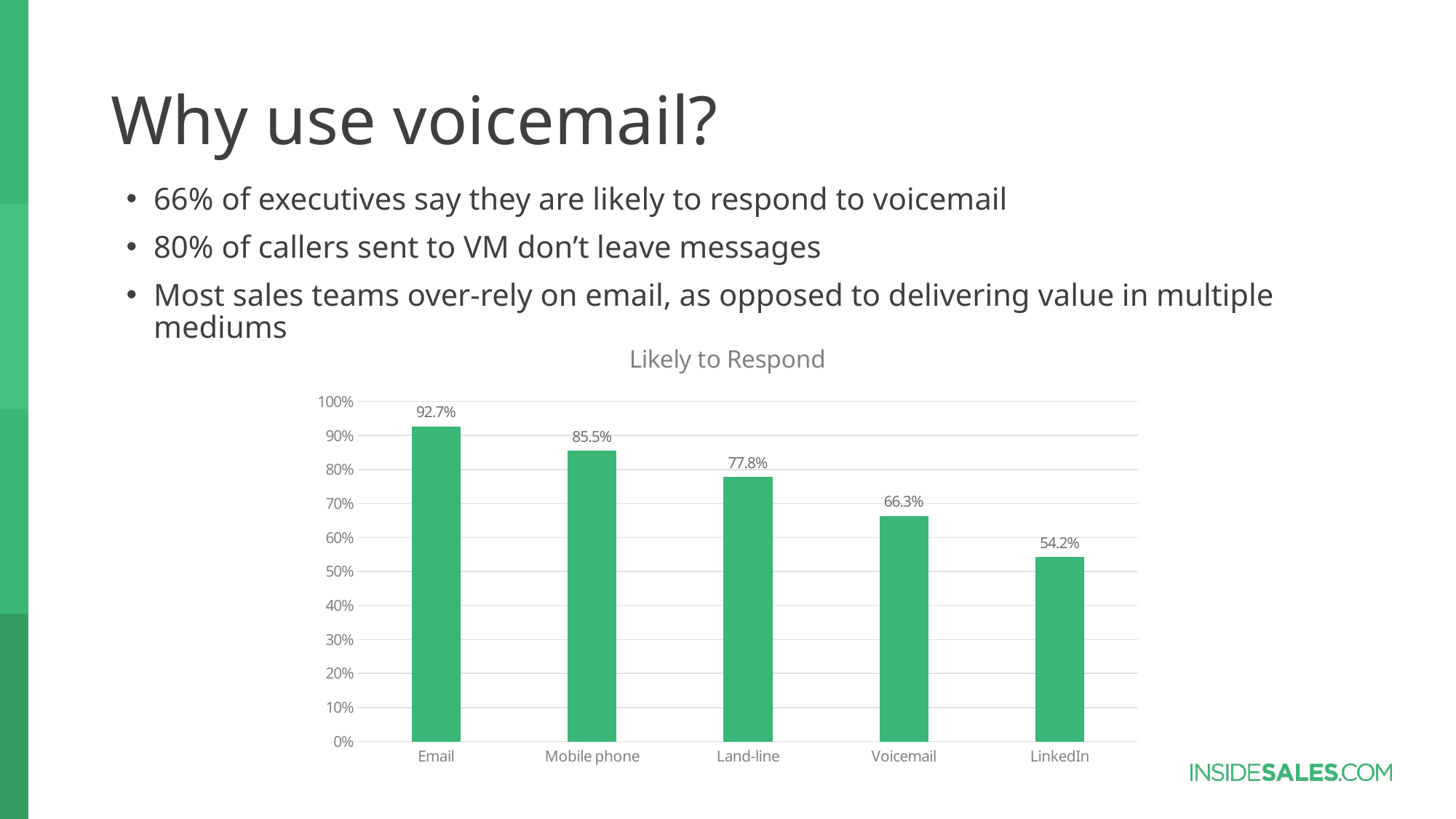
What is the value for LinkedIn? 54.2% Which category has the highest value? Email What is the value for Voicemail? 66.3% What is the title of the chart? Likely to Respond Is the value for Mobile phone greater or less than 80%? greater Which category has the lowest value? LinkedIn How many categories are shown on the x axis? 5 Which is larger, the value for Land-line or the value for LinkedIn? Land-line What kind of chart is shown on the slide? bar chart What is the value for Email? 92.7% What is the difference between the values for Mobile phone and Land-line? 7.7% What is the difference between the values for Email and Voicemail? 26.4%